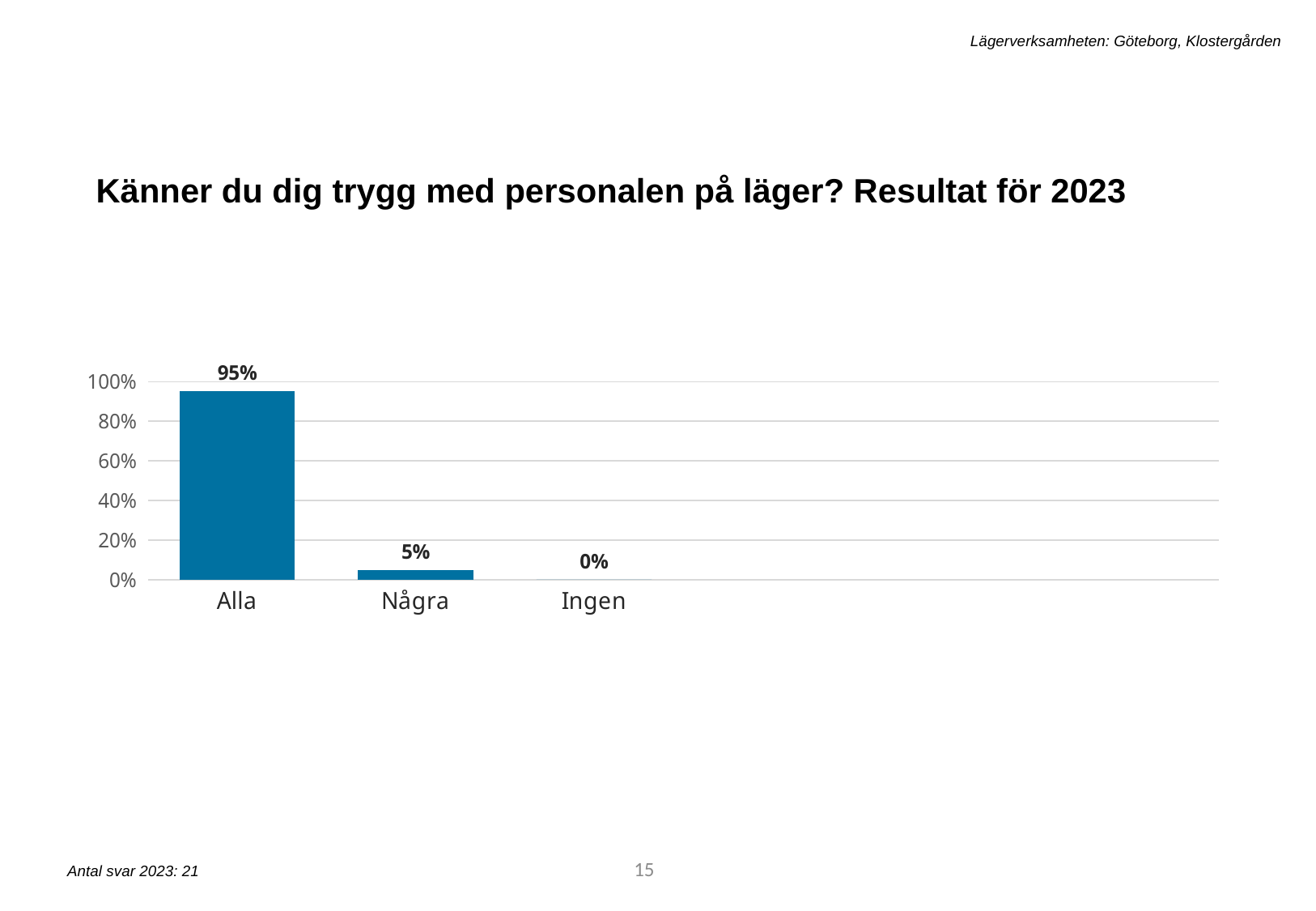
Do the values rise or fall from Alla to Ingen along the x axis? fall What is the value for Alla? 95% Which category has the highest value? Alla Which is larger, the value for Några or the value for Ingen? Några What is the value for Några? 5% What is the difference between the values for Alla and Några? 90% Which category has the lowest value? Ingen What is the value for Ingen? 0% Is the value for Alla greater or less than 80%? greater What is the title of the slide containing the chart? Känner du dig trygg med personalen på läger? Resultat för 2023 What kind of chart is shown on the slide? bar chart How many categories are shown on the x axis? 3